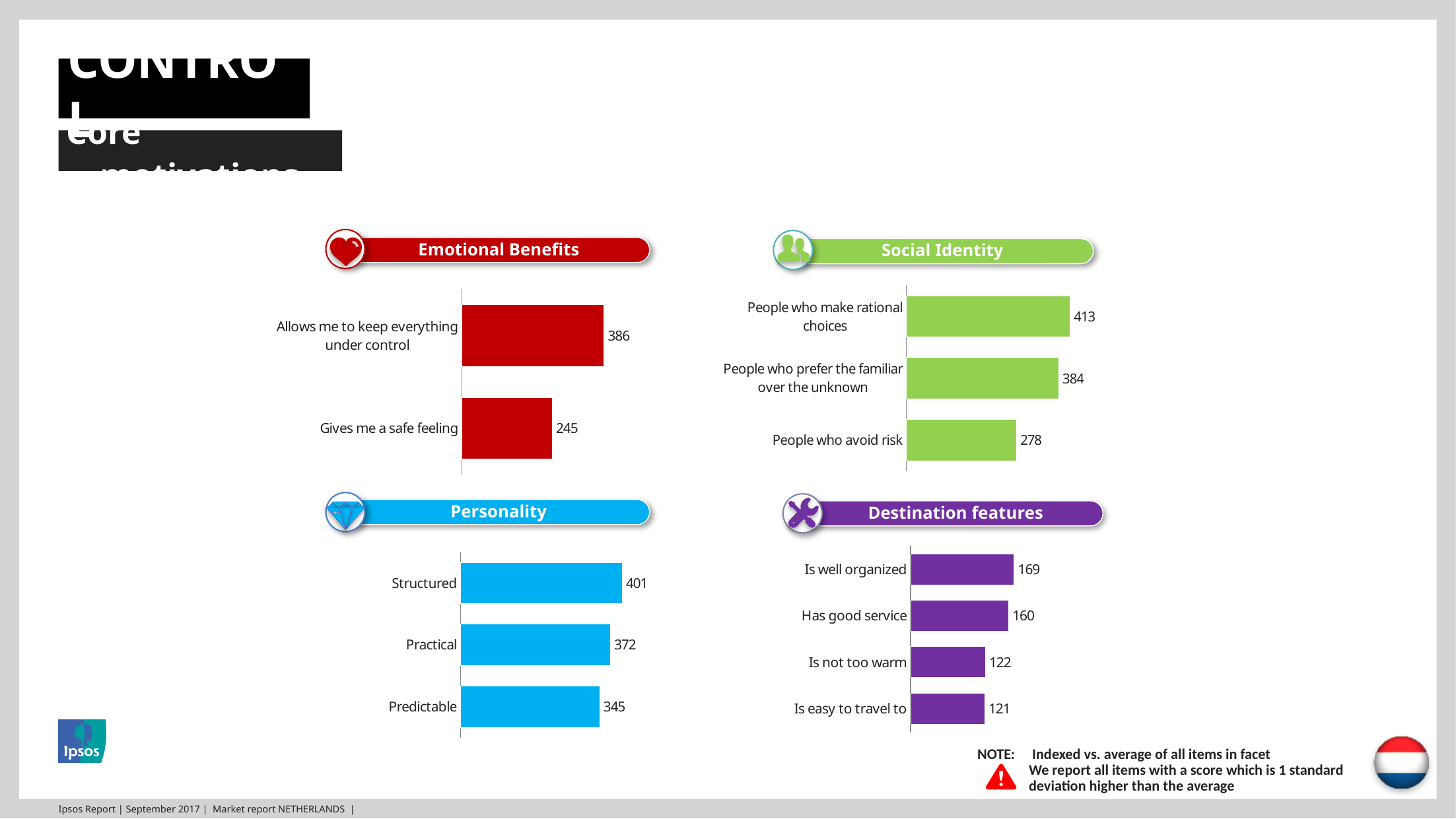
In the Personality chart, what is the value for "Practical"? 372 In the Destination features chart, which category has the highest value? Is well organized In the Destination features chart, how many categories are shown? 4 In the Social Identity chart, what is the difference between "People who make rational choices" and "People who prefer the familiar over the unknown"? 29 In the Emotional Benefits chart, what is the value for "Gives me a safe feeling"? 245 What kind of chart is the Emotional Benefits chart? Bar chart In the Personality chart, how many categories are shown? 3 In the Social Identity chart, which category has the highest value? People who make rational choices In the Destination features chart, what is the value for "Has good service"? 160 In the Emotional Benefits chart, what is the value for "Allows me to keep everything under control"? 386 In the Social Identity chart, what is the value for "People who avoid risk"? 278 In the Personality chart, which category has the lowest value? Predictable